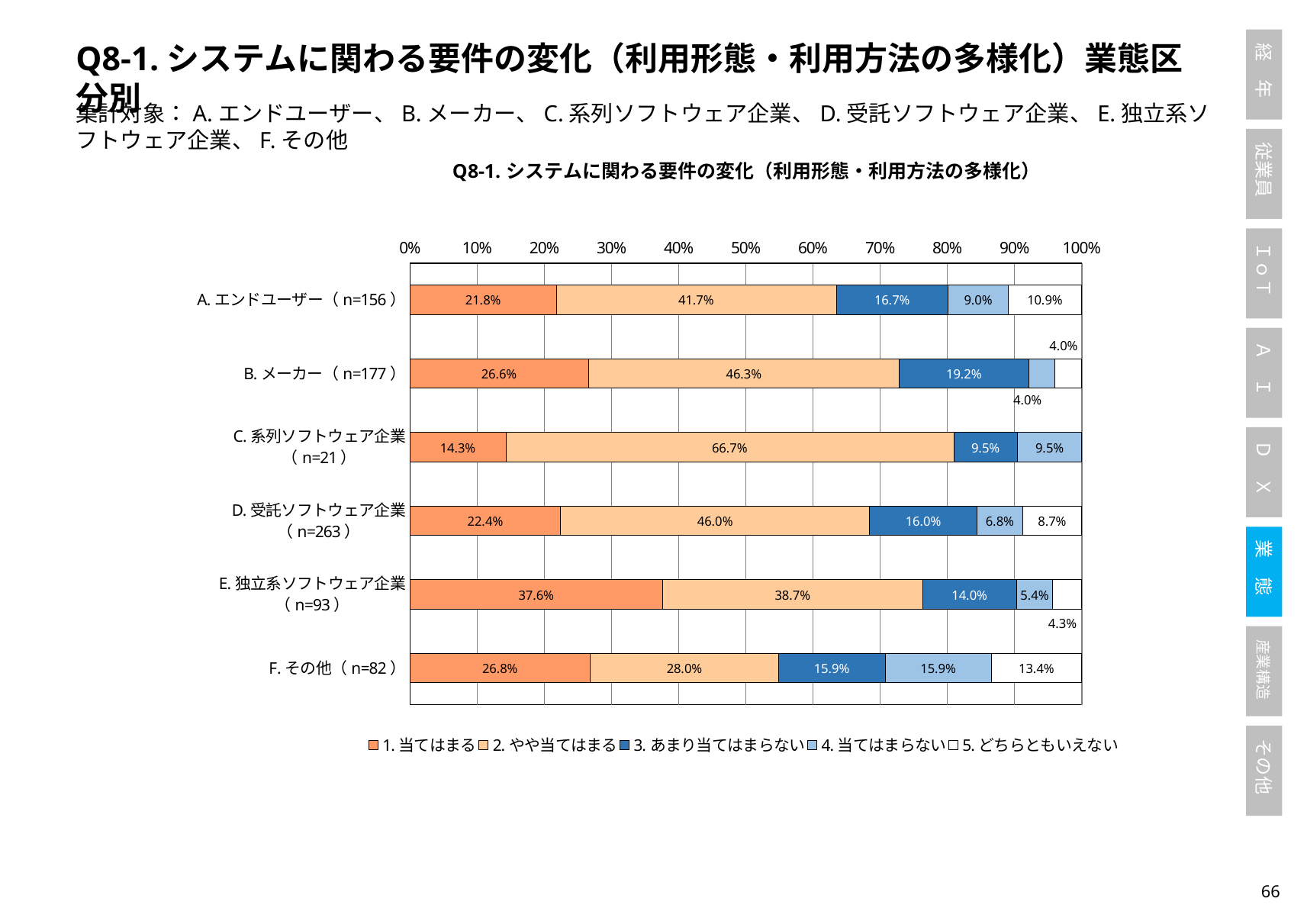
What is the sample size (n) shown for D. 受託ソフトウェア企業? 263 What is the value of 「3. あまり当てはまらない」 for B. メーカー? 19.2% Which category has the highest value for 「1. 当てはまる」? E. 独立系ソフトウェア企業 What is the value of 「5. どちらともいえない」 for F. その他? 13.4% Which category has the lowest value for 「2. やや当てはまる」? F. その他 What type of chart is shown on the slide? Stacked bar chart What is the value of 「1. 当てはまる」 for E. 独立系ソフトウェア企業? 37.6% What is the value of 「2. やや当てはまる」 for C. 系列ソフトウェア企業? 66.7% How many series does the legend list? 5 What is the difference between the 「1. 当てはまる」 values of B. メーカー and A. エンドユーザー? 4.8% Which is larger: the 「4. 当てはまらない」 value for A. エンドユーザー or for D. 受託ソフトウェア企業? A. エンドユーザー How many categories (業態) are plotted on the chart? 6